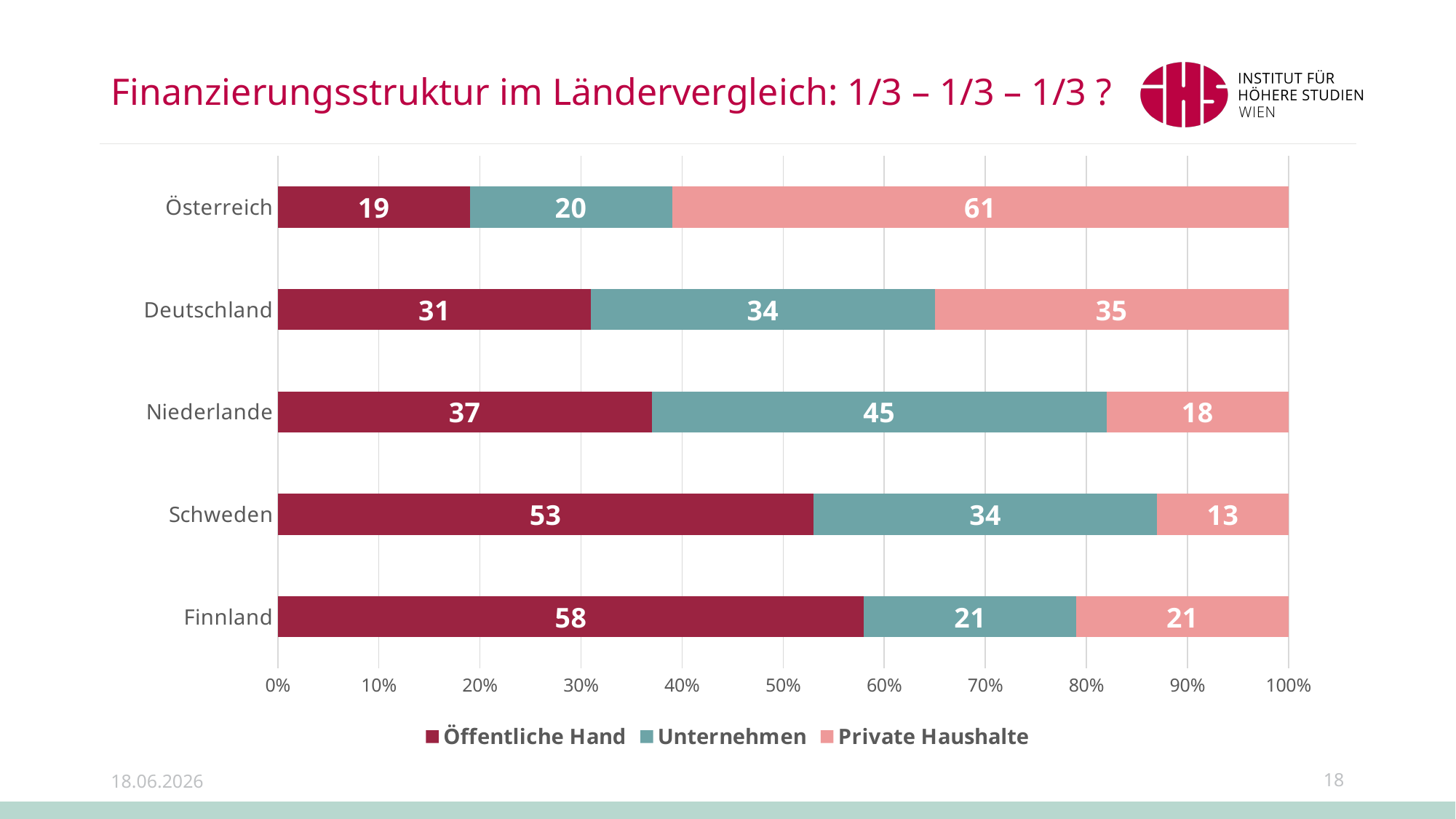
What is the title of the chart on the slide? Finanzierungsstruktur im Ländervergleich: 1/3 – 1/3 – 1/3 ? What is the difference between the Private Haushalte values for Österreich and Deutschland? 26 How many series does the legend list? 3 Which country has the lowest value for Private Haushalte? Schweden What is the total of the stacked bar for Niederlande? 100 What is the value for Private Haushalte for Schweden? 13 What is the value for Unternehmen for Niederlande? 45 What kind of chart is shown on the slide? Stacked bar chart How many countries are shown on the chart? 5 What is the value for Öffentliche Hand for Österreich? 19 Which is larger: the Unternehmen value for Deutschland or for Finnland? Deutschland Which country has the highest value for Öffentliche Hand? Finnland